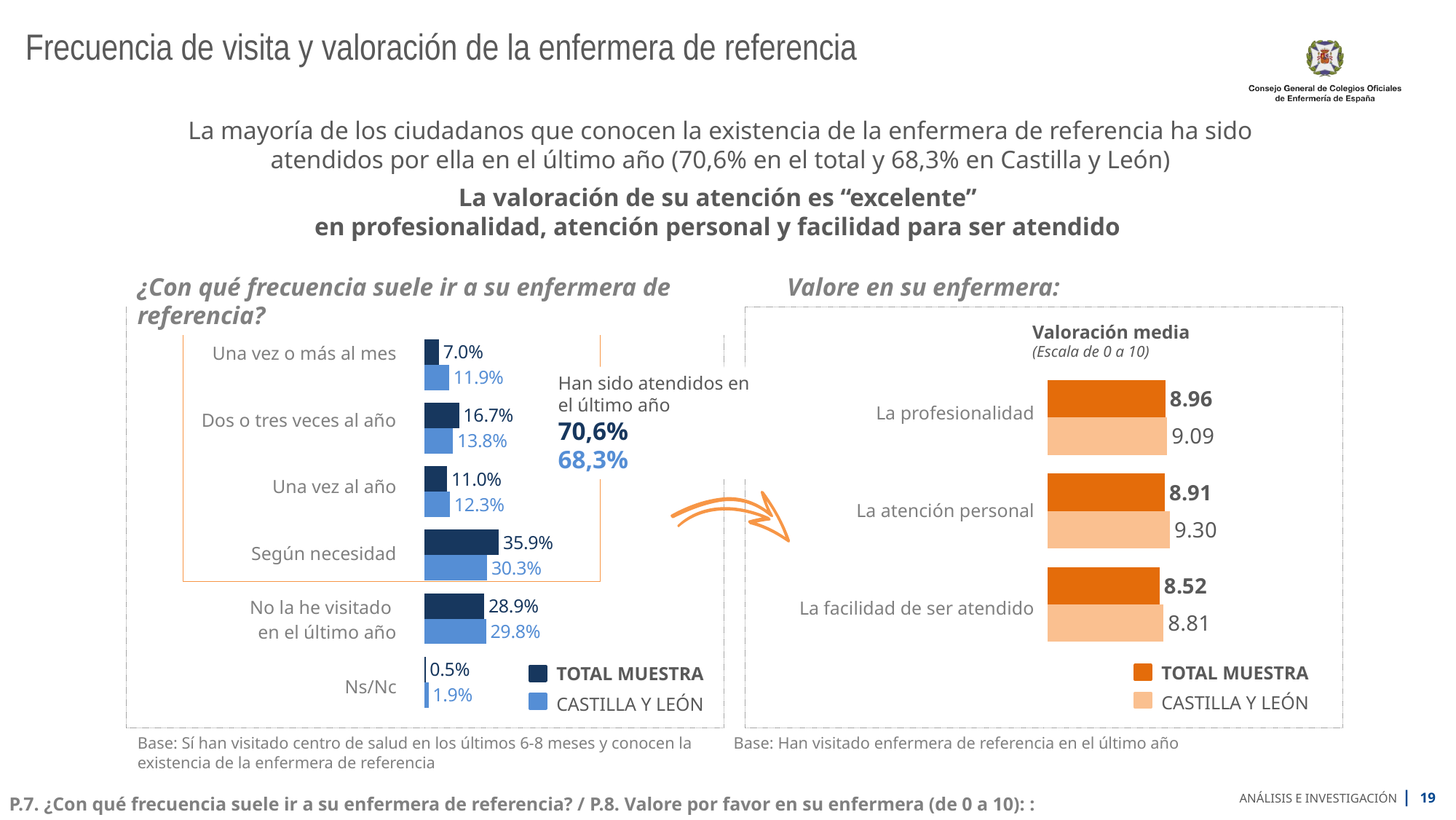
In the left chart (¿Con qué frecuencia suele ir a su enfermera de referencia?), which category has the lowest CASTILLA Y LEÓN value? Ns/Nc How many series does the legend of the right chart (Valore en su enfermera) list? 2 In the left chart (¿Con qué frecuencia suele ir a su enfermera de referencia?), what is the CASTILLA Y LEÓN value for 'Una vez o más al mes'? 11.9% In the left chart (¿Con qué frecuencia suele ir a su enfermera de referencia?), what is the TOTAL MUESTRA value for 'Según necesidad'? 35.9% In the left chart (¿Con qué frecuencia suele ir a su enfermera de referencia?), what is the difference between the TOTAL MUESTRA and CASTILLA Y LEÓN values for 'Según necesidad'? 5.6% In the right chart (Valore en su enfermera), what is the CASTILLA Y LEÓN score for 'La atención personal'? 9.30 In the left chart (¿Con qué frecuencia suele ir a su enfermera de referencia?), which is larger for 'Dos o tres veces al año': TOTAL MUESTRA or CASTILLA Y LEÓN? TOTAL MUESTRA In the left chart (¿Con qué frecuencia suele ir a su enfermera de referencia?), which category has the highest TOTAL MUESTRA value? Según necesidad In the right chart (Valore en su enfermera), what is the difference between the CASTILLA Y LEÓN and TOTAL MUESTRA scores for 'La profesionalidad'? 0.13 What kind of chart is the right chart (Valore en su enfermera)? Bar chart How many categories are shown in the left chart (¿Con qué frecuencia suele ir a su enfermera de referencia?)? 6 In the right chart (Valore en su enfermera), which item has the lowest TOTAL MUESTRA score? La facilidad de ser atendido